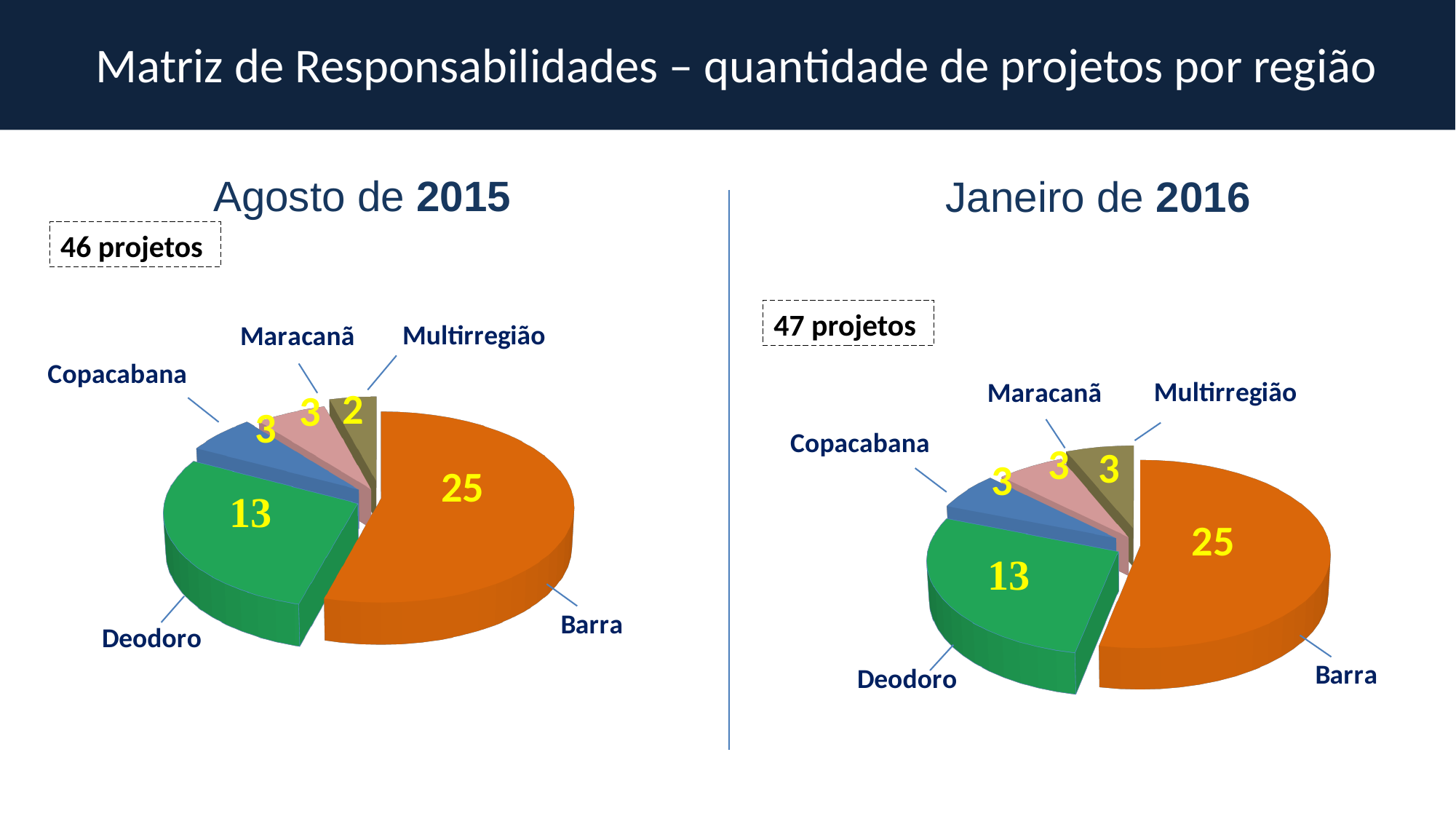
In the Agosto de 2015 chart, which region has the fewest projects? Multirregião In the Agosto de 2015 chart, how many projects are in Barra? 25 In the Agosto de 2015 chart, which region has the most projects? Barra In the Agosto de 2015 chart, which has more projects, Deodoro or Copacabana? Deodoro In the Janeiro de 2016 chart, what is the difference between the number of projects in Barra and in Deodoro? 12 In the Janeiro de 2016 chart, how many projects are in Deodoro? 13 In the Agosto de 2015 chart, how many projects are in Multirregião? 2 In the Janeiro de 2016 chart, which region has the most projects? Barra In the Janeiro de 2016 chart, how many projects are in Multirregião? 3 What kind of chart is used for Agosto de 2015? Pie chart How many regions are shown in the Janeiro de 2016 chart? 5 What is the total number of projects shown for Janeiro de 2016? 47 projetos